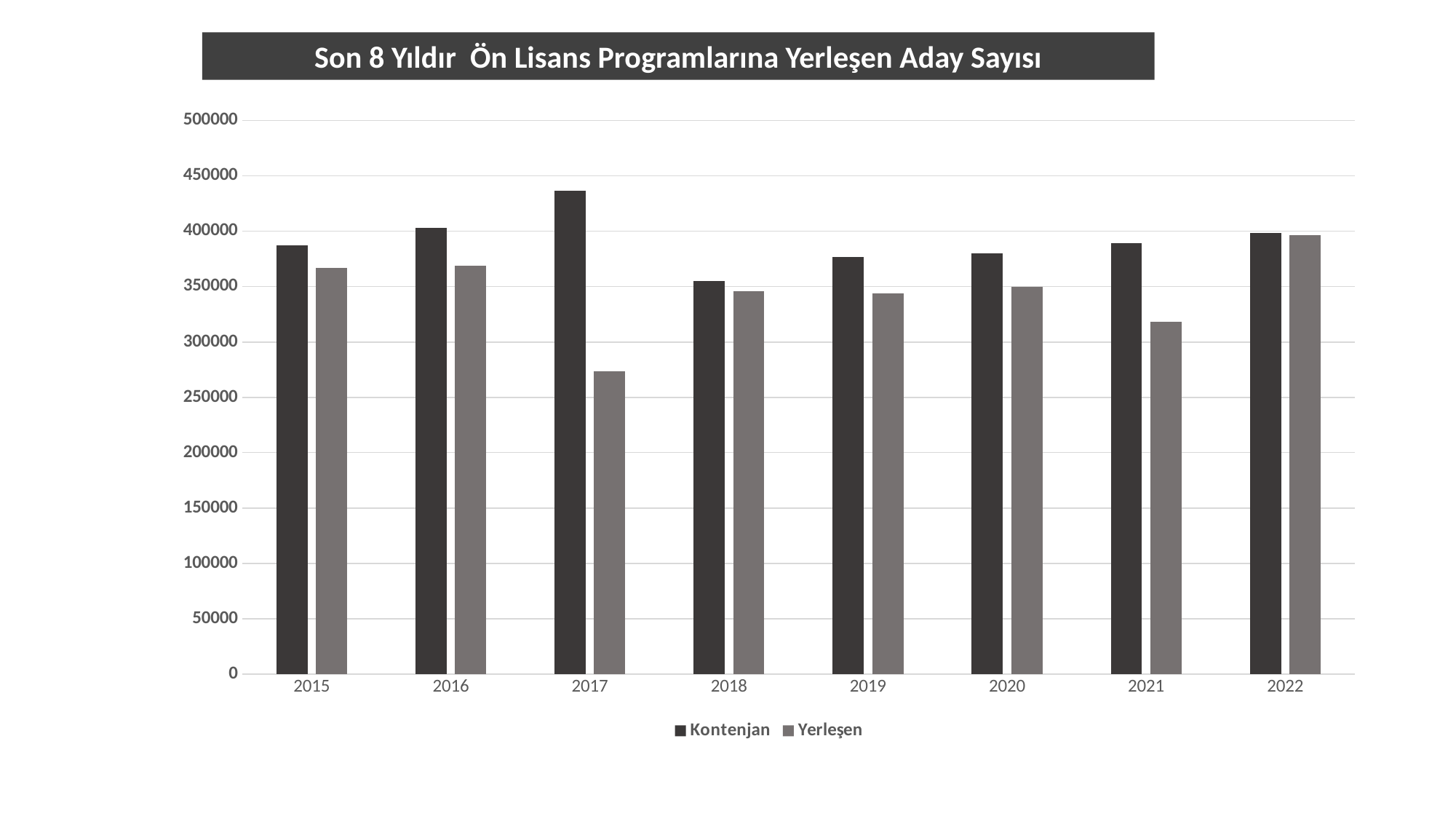
In which year is the Kontenjan value highest? 2017 Does the Yerleşen value rise or fall from 2021 to 2022? rise How many years are shown on the x axis? 8 What is the title of the chart? Son 8 Yıldır Ön Lisans Programlarına Yerleşen Aday Sayısı Is the Kontenjan value for 2017 greater or less than 400000? greater Is the Yerleşen value for 2017 greater or less than 300000? less How many series does the legend list? 2 What kind of chart is shown on the slide? bar chart In 2021, which is larger, Kontenjan or Yerleşen? Kontenjan In which year is the Yerleşen value lowest? 2017 Is the Yerleşen value for 2021 greater or less than 350000? less In which year is the Yerleşen value highest? 2022